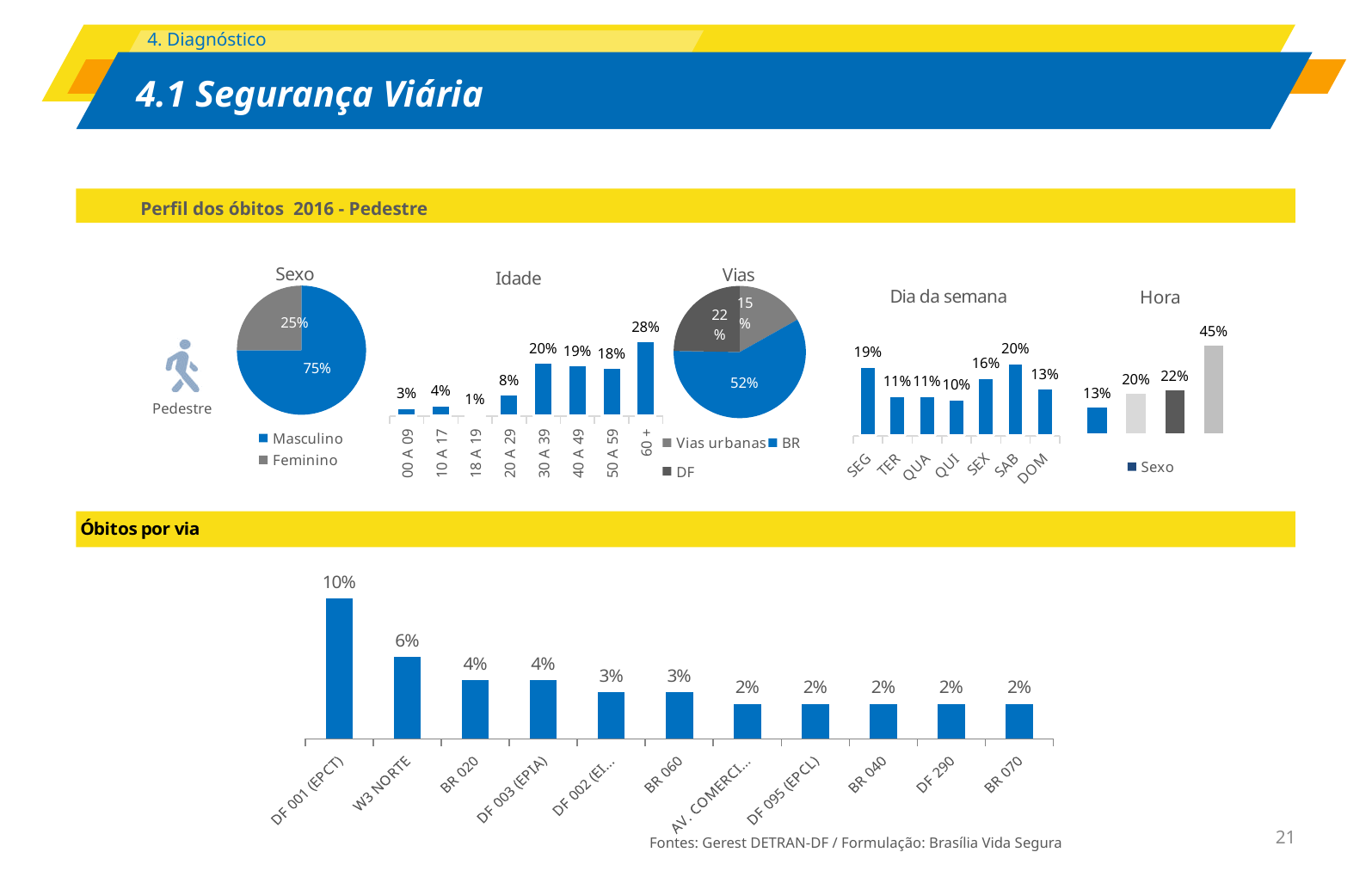
In the 'Sexo' pie chart, what share of pedestrian deaths is Masculino? 75% In the 'Hora' bar chart, what is the highest value shown? 45% In the 'Óbitos por via' bar chart, which is larger, DF 001 (EPCT) or BR 020? DF 001 (EPCT) In the 'Idade' bar chart, which age group has the highest value? 60 + In the 'Sexo' pie chart, what share is Feminino? 25% In the 'Dia da semana' bar chart, what is the difference between SEG and QUI? 9% In the 'Idade' bar chart, what is the value for the 30 A 39 age group? 20% In the 'Idade' bar chart, which age group has the lowest value? 18 A 19 In the 'Dia da semana' bar chart, which day has the highest value? SAB In the 'Vias' pie chart, what share corresponds to BR? 52% In the 'Óbitos por via' bar chart, what is the value for W3 NORTE? 6% In the 'Idade' bar chart, how many age groups are shown? 8